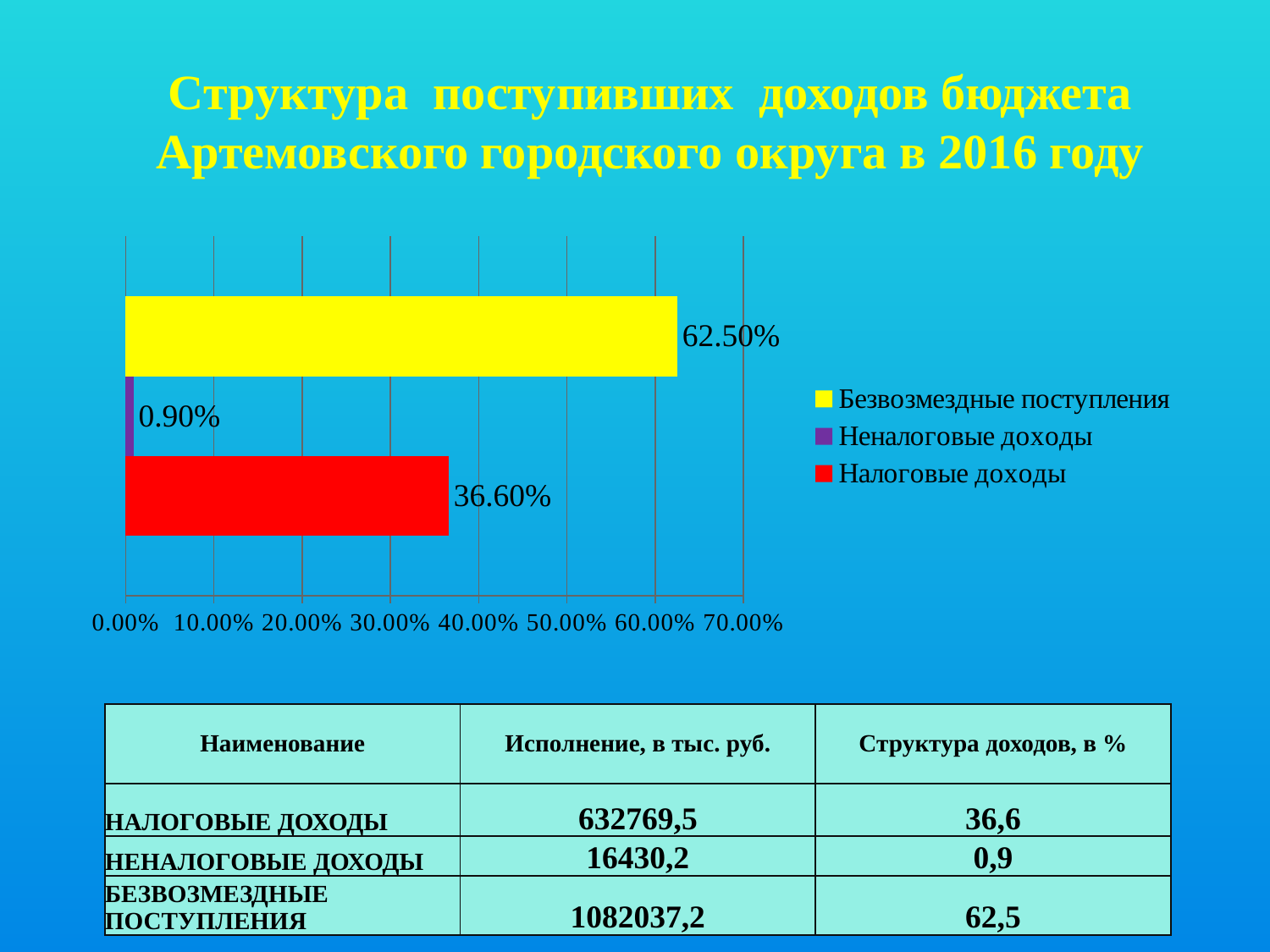
What kind of chart is shown on the slide? bar chart Is the value for Безвозмездные поступления greater or less than 60.00%? greater What is the value shown for Неналоговые доходы in the chart? 0.90% What colour is the bar for Налоговые доходы? red What is the value shown for Налоговые доходы in the chart? 36.60% What is the value shown for Безвозмездные поступления in the chart? 62.50% Which category has the lowest value in the chart? Неналоговые доходы Which category has the highest value in the chart? Безвозмездные поступления What is the difference between the values for Безвозмездные поступления and Налоговые доходы? 25.90% How many bars are plotted in the chart? 3 How many entries does the chart legend list? 3 Which is larger: the value for Налоговые доходы or the value for Неналоговые доходы? Налоговые доходы